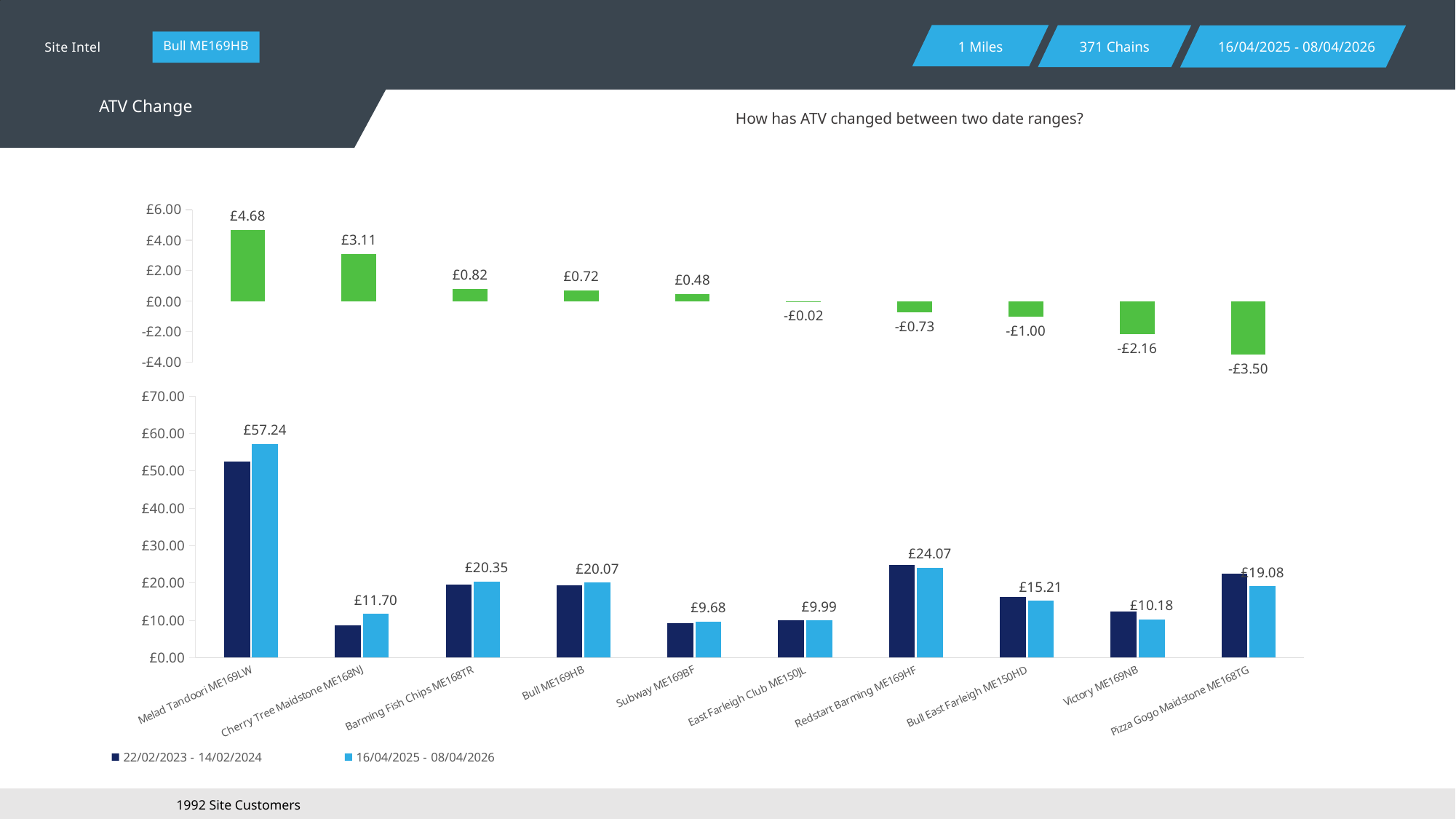
In the bottom chart, which is larger in the 16/04/2025 - 08/04/2026 series: Redstart Barming ME169HF or Pizza Gogo Maidstone ME168TG? Redstart Barming ME169HF In the bottom chart, is the 22/02/2023 - 14/02/2024 value for Melad Tandoori ME169LW greater or less than £50.00? greater In the bottom chart, what is the difference between the 16/04/2025 - 08/04/2026 values for Barming Fish Chips ME168TR and Bull ME169HB? £0.28 In the top chart, what is the highest value shown? £4.68 In the bottom chart, which category has the lowest value in the 16/04/2025 - 08/04/2026 series? Subway ME169BF In the bottom chart, what is the value for Melad Tandoori ME169LW in the 16/04/2025 - 08/04/2026 series? £57.24 What kind of chart is the top chart? bar chart In the bottom chart, how many series does the legend list? 2 In the bottom chart, which category has the highest value in the 16/04/2025 - 08/04/2026 series? Melad Tandoori ME169LW In the bottom chart, how many categories are shown on the x axis? 10 In the bottom chart, what is the value for Redstart Barming ME169HF in the 16/04/2025 - 08/04/2026 series? £24.07 In the top chart, what is the lowest value shown? -£3.50